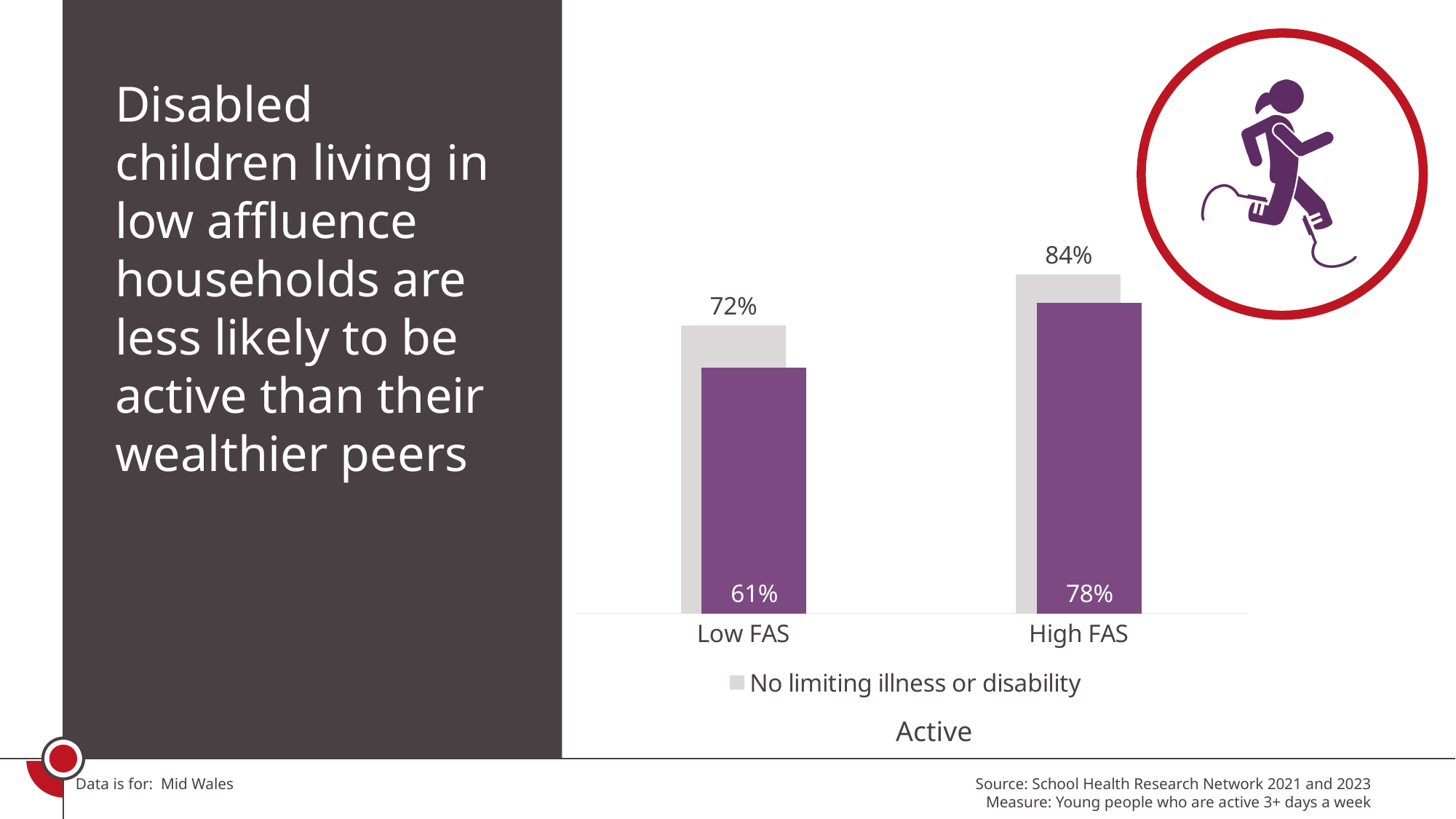
Which category has the higher value for 'No limiting illness or disability', Low FAS or High FAS? High FAS What is the title of the chart? Active What is the value for 'No limiting illness or disability' in the Low FAS category? 72% Which bar in the chart has the lowest value? The purple bar for Low FAS (61%) What type of chart is shown on the slide? Bar chart What value is shown on the purple bar for High FAS? 78% What value is shown on the purple bar for Low FAS? 61% What is the difference between the 'No limiting illness or disability' values for High FAS and Low FAS? 12% What is the difference between the grey bar and the purple bar in the Low FAS category? 11% What is the difference between the grey bar and the purple bar in the High FAS category? 6% What is the value for 'No limiting illness or disability' in the High FAS category? 84% How many categories are shown on the x axis of the chart? 2